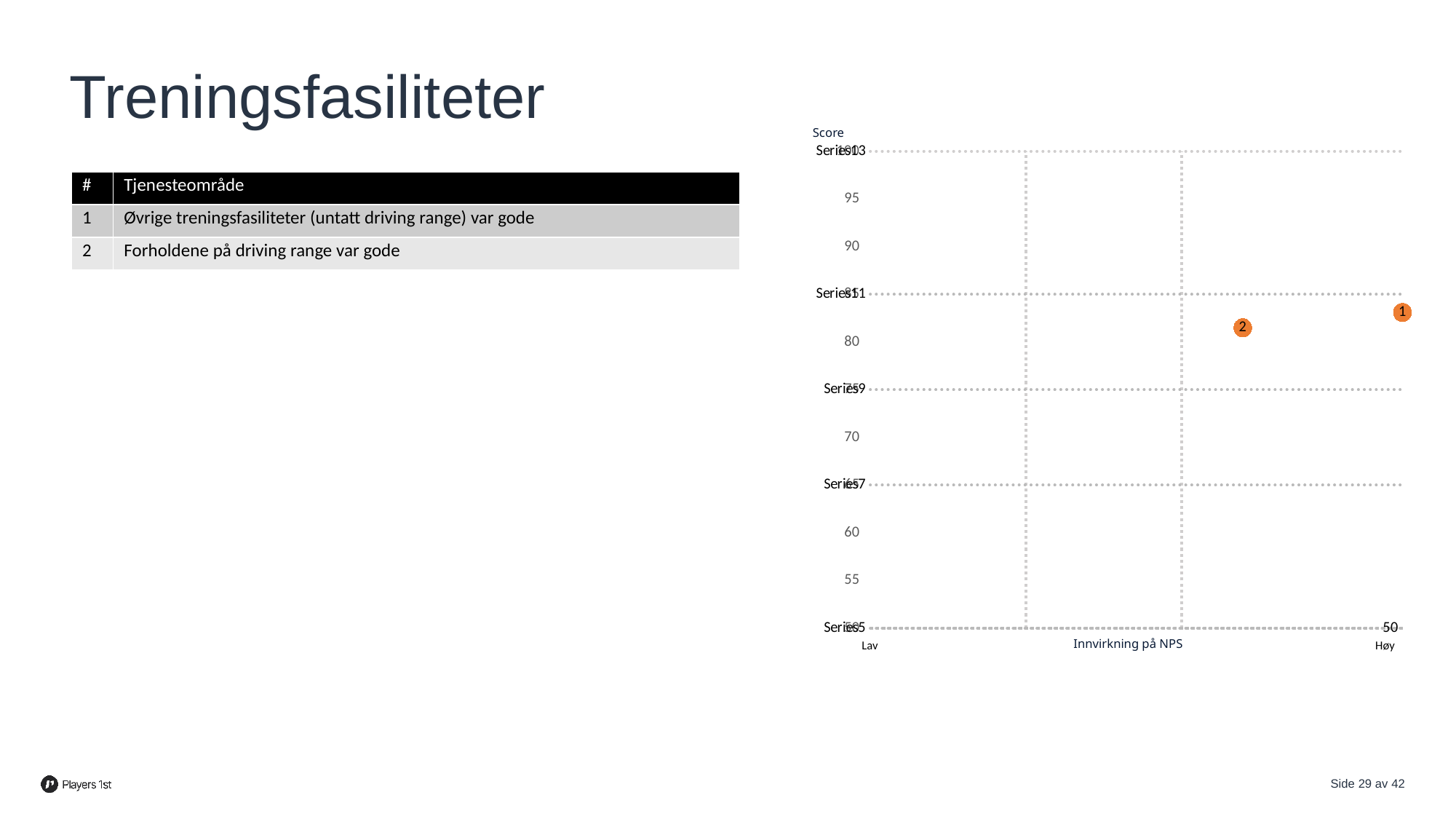
How many data points are plotted on the chart? 2 Is the score for point 2 greater or less than 75? greater Is the score for point 1 greater or less than 85? less What is the title of the horizontal axis of the chart? Innvirkning på NPS What is the title of the vertical axis of the chart? Score Which point has the higher score, point 1 or point 2? point 1 What is the highest value shown on the Score axis? 100 Which point has the higher impact on NPS (Innvirkning på NPS), point 1 or point 2? point 1 What kind of chart is shown on the slide? scatter chart Is the score for point 2 greater or less than 85? less